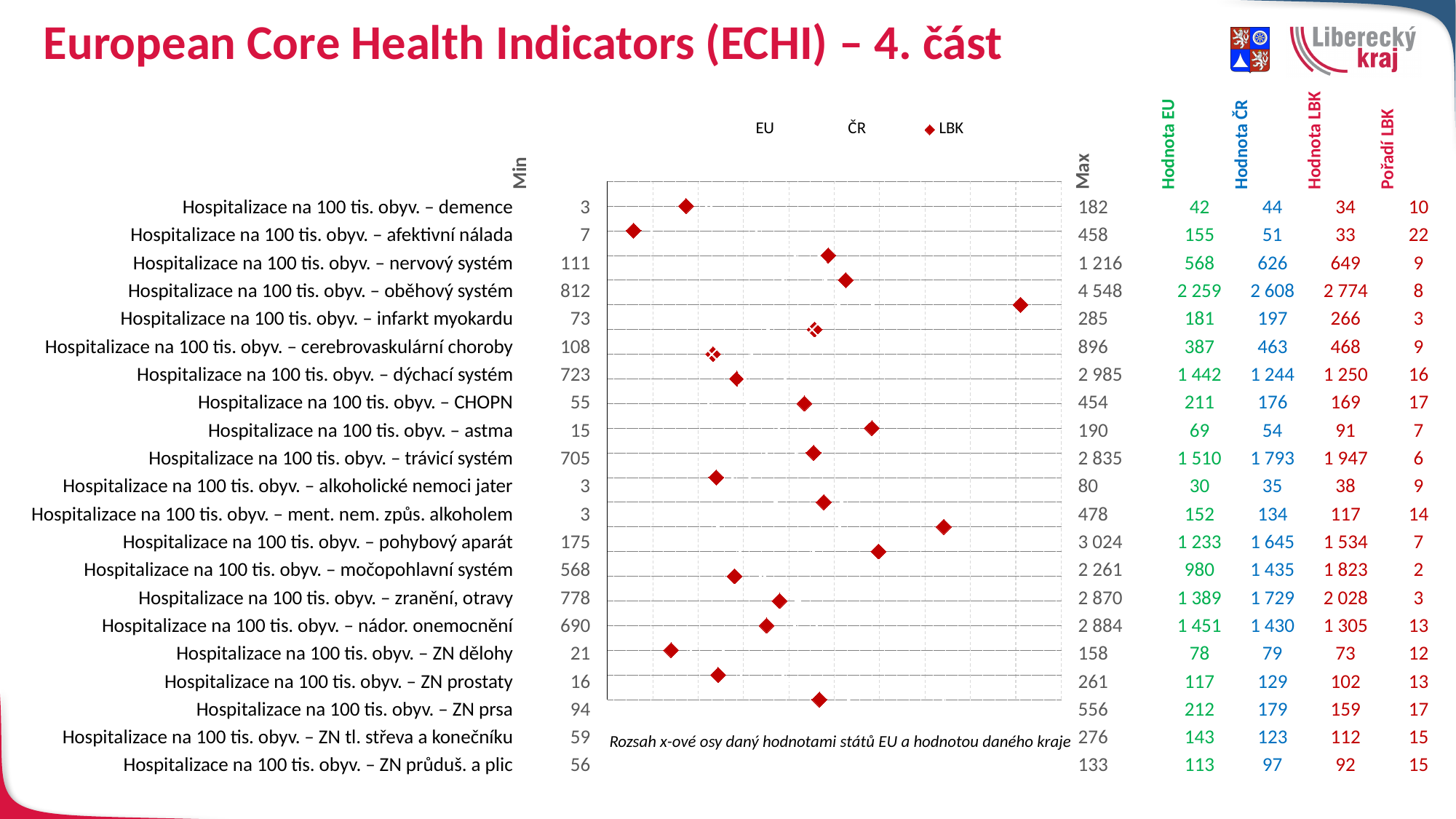
For Hospitalizace na 100 tis. obyv. – astma, which is larger: the Hodnota ČR value or the Hodnota LBK value? Hodnota LBK What is the Pořadí LBK for Hospitalizace na 100 tis. obyv. – močopohlavní systém? 2 What is the Max value shown for Hospitalizace na 100 tis. obyv. – oběhový systém? 4 548 What is the difference between the Hodnota LBK and Hodnota EU values for Hospitalizace na 100 tis. obyv. – infarkt myokardu? 85 What is the Hodnota EU value for Hospitalizace na 100 tis. obyv. – dýchací systém? 1 442 Which indicator has the highest Hodnota LBK value? Hospitalizace na 100 tis. obyv. – oběhový systém How many series does the chart legend list? 3 Which indicator has the lowest Hodnota LBK value? Hospitalizace na 100 tis. obyv. – afektivní nálada How many indicators (rows) are plotted on the chart? 21 Which series in the legend is marked with a red diamond? LBK What kind of chart is shown on the slide? Scatter (dot) chart What is the Hodnota LBK value for Hospitalizace na 100 tis. obyv. – infarkt myokardu? 266